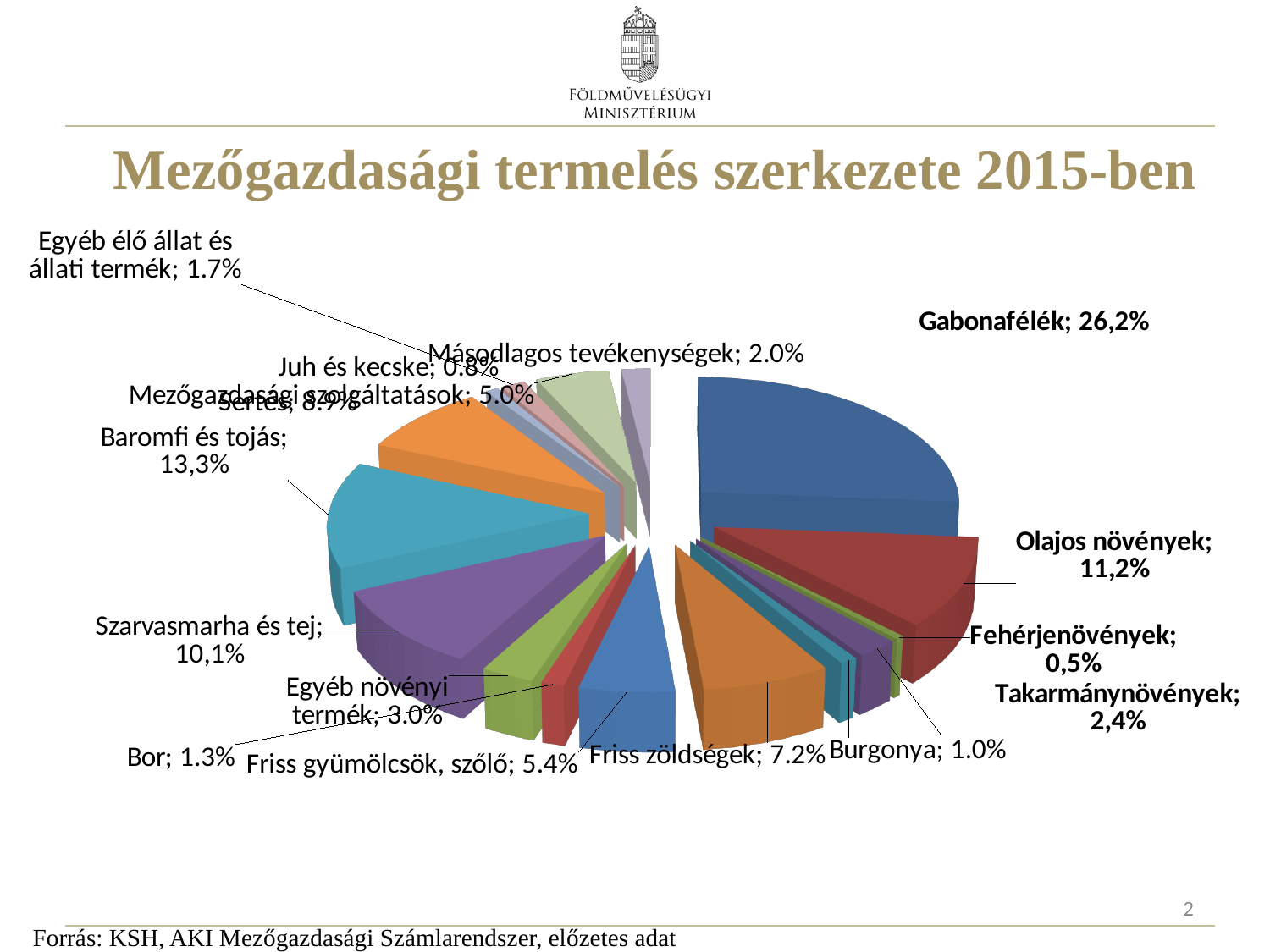
What is the combined share of Bor and Burgonya? 2.3% What is the value shown for Takarmánynövények? 2,4% Which category has the smallest share of the pie? Fehérjenövények Which category has the largest share of the pie? Gabonafélék What is the value shown for Baromfi és tojás? 13,3% What is the value shown for Szarvasmarha és tej? 10,1% What is the title of the chart? Mezőgazdasági termelés szerkezete 2015-ben What is the difference between the shares of Friss zöldségek and Friss gyümölcsök, szőlő? 1.8% What kind of chart is shown on the slide? pie chart What share does Gabonafélék have in the pie? 26,2% What is the value shown for Friss zöldségek? 7.2% Which is larger, Olajos növények or Szarvasmarha és tej? Olajos növények